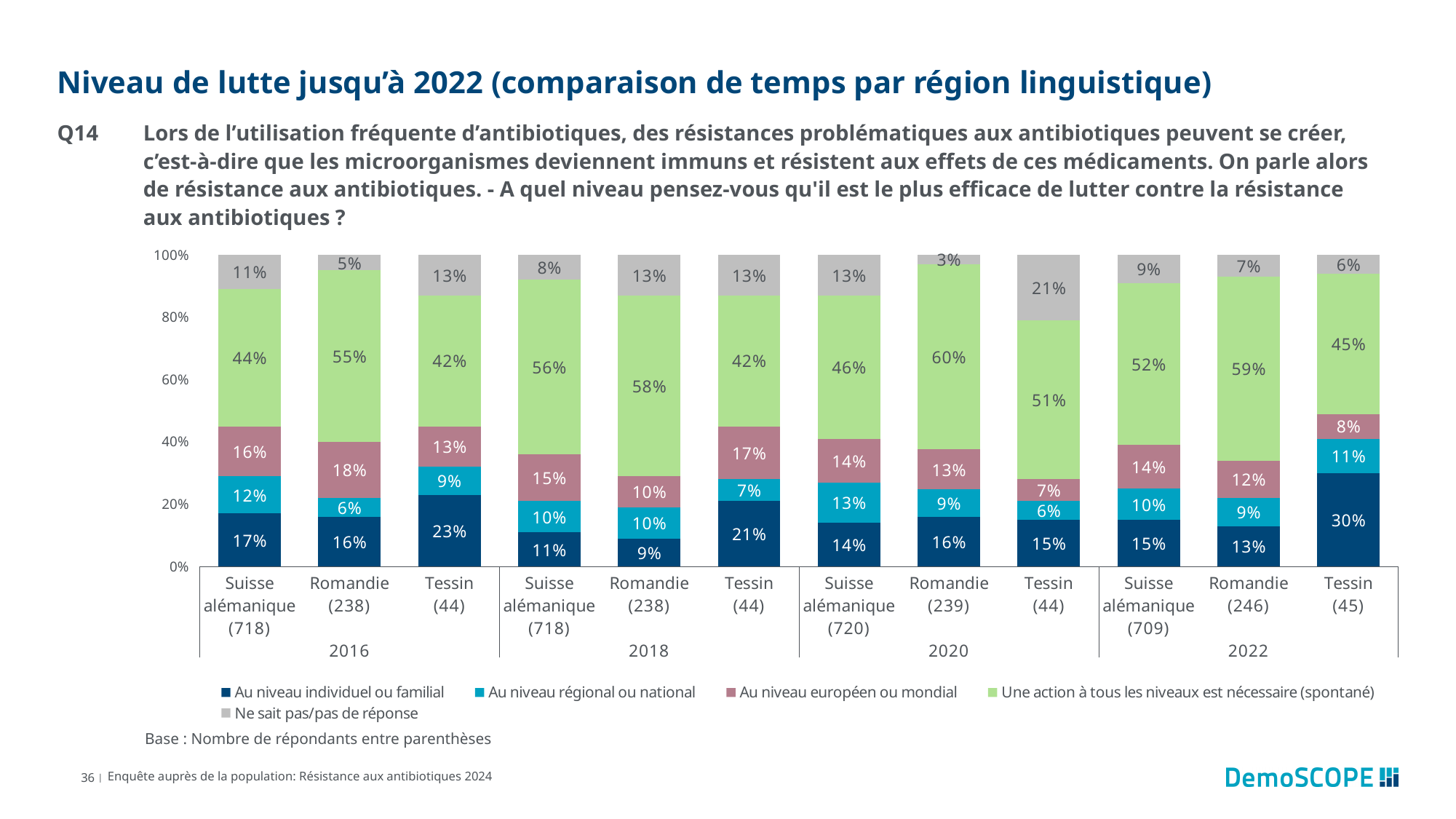
What share of respondents in Tessin in 2020 answered 'Ne sait pas/pas de réponse'? 21% What is the value for 'Au niveau régional ou national' for Suisse alémanique in 2016? 12% How many respondents are in the base for Suisse alémanique in 2020? 720 In 2018, which region has the larger value for 'Au niveau européen ou mondial': Suisse alémanique or Tessin? Tessin What percentage of respondents in Tessin in 2022 chose 'Au niveau individuel ou familial'? 30% What is the value for 'Une action à tous les niveaux est nécessaire (spontané)' for Romandie in 2020? 60% What is the difference between the 'Une action à tous les niveaux est nécessaire (spontané)' values for Romandie and Tessin in 2022? 14 percentage points How many bars are shown in the chart? 12 Across all bars, which region and year has the highest value for 'Au niveau individuel ou familial'? Tessin, 2022 Across all bars, which region and year has the lowest value for 'Ne sait pas/pas de réponse'? Romandie, 2020 How many series does the legend list? 5 What kind of chart is shown on the slide? Stacked bar chart